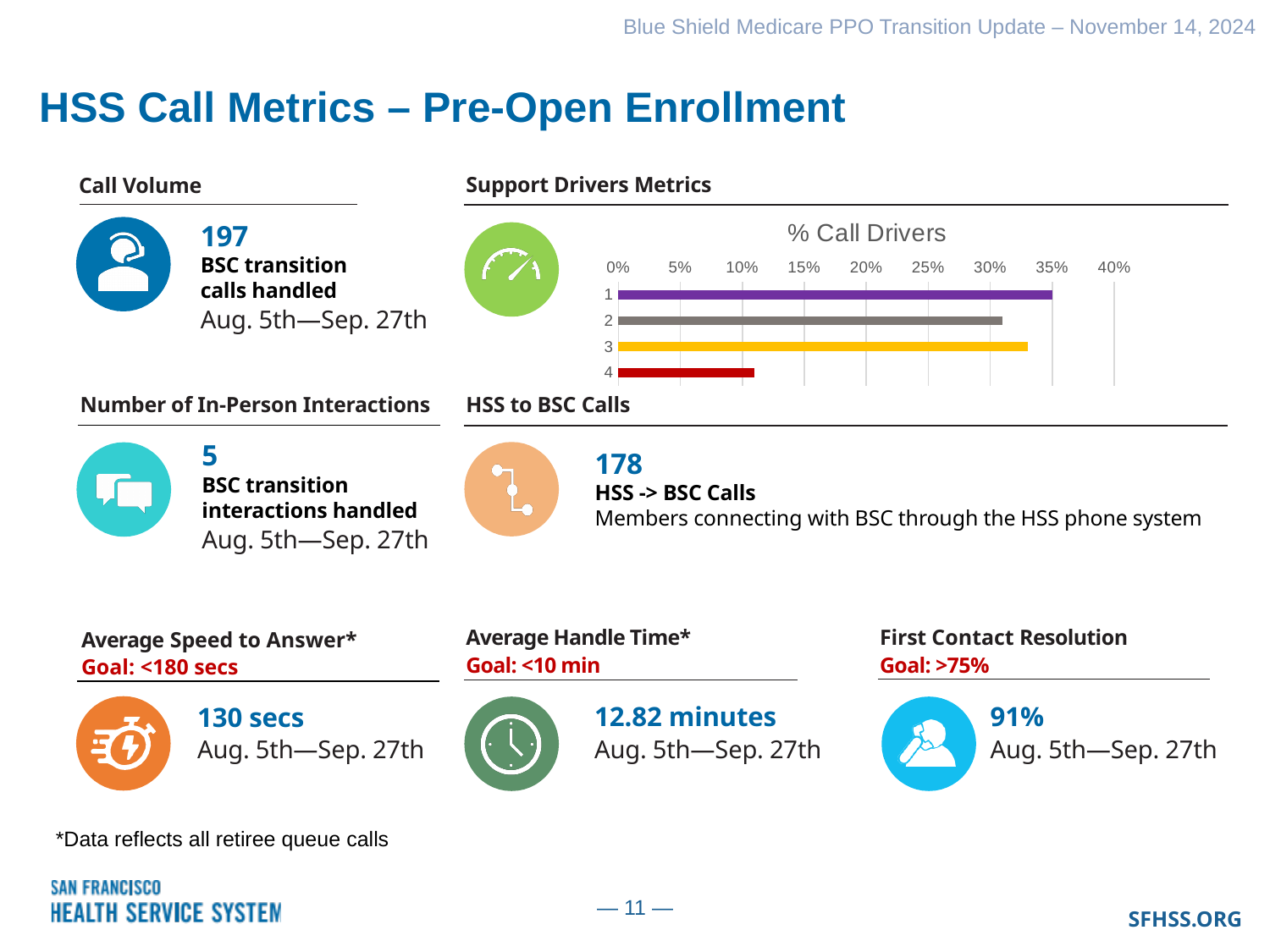
What is the title of the chart on the slide? % Call Drivers In the "% Call Drivers" chart, which category has the shortest bar? 4 In the "% Call Drivers" chart, is the value for category 3 greater or less than 30%? greater In the "% Call Drivers" chart, which category has the longest bar? 1 In the "% Call Drivers" chart, which is larger, the value for category 3 or the value for category 2? category 3 In the "% Call Drivers" chart, is the value for category 1 greater or less than 30%? greater How many categories are plotted in the "% Call Drivers" chart? 4 In the "% Call Drivers" chart, which is larger, the value for category 1 or the value for category 4? category 1 What kind of chart is the "% Call Drivers" chart? bar chart In the "% Call Drivers" chart, is the value for category 2 greater or less than 25%? greater What is the highest value shown on the axis of the "% Call Drivers" chart? 40%